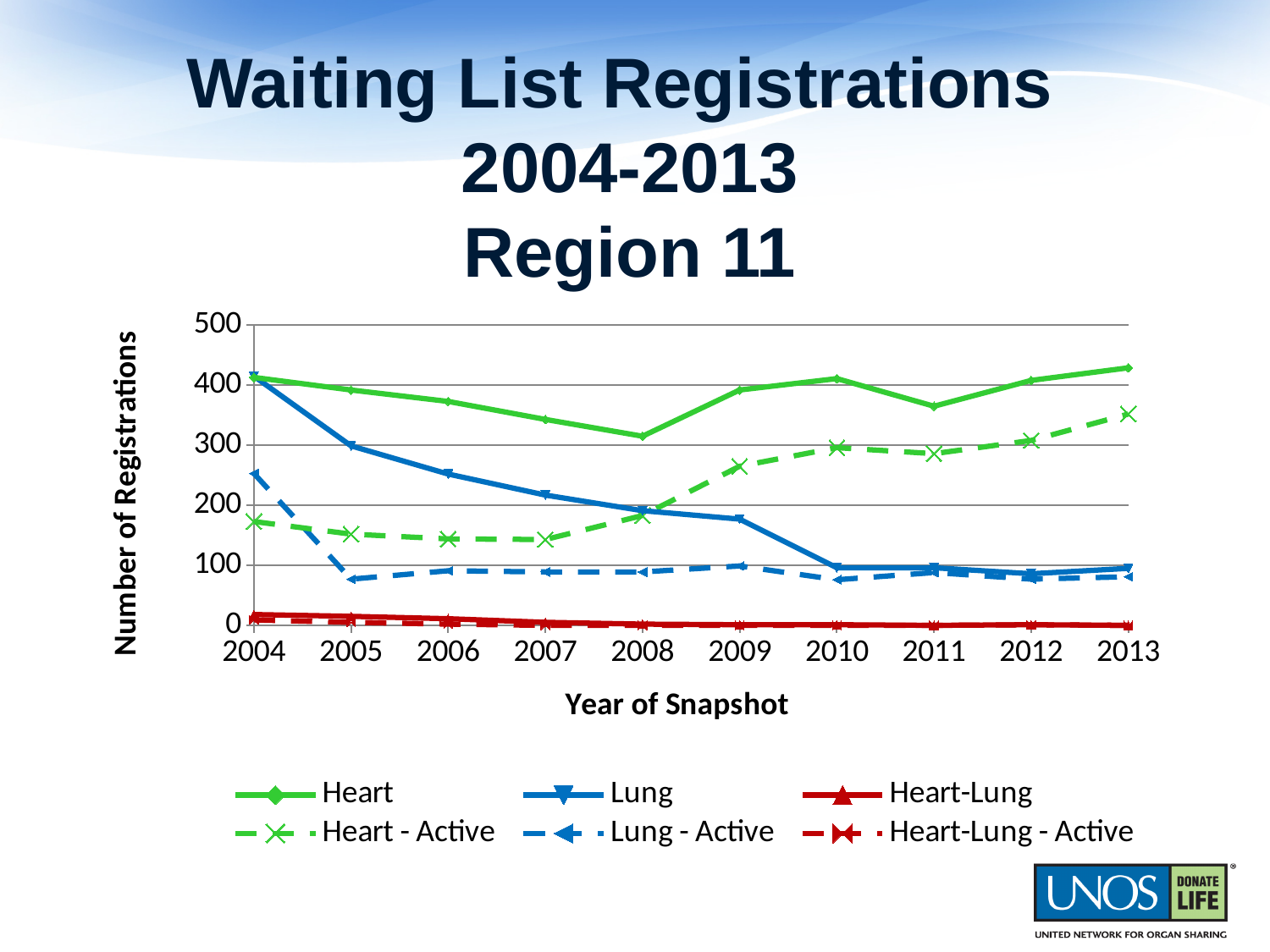
Is the Lung value for 2004 greater or less than 300? greater Is the Lung value for 2010 greater or less than 200? less Does the Lung series rise or fall from 2004 to 2013? fall How many series does the legend list? 6 What kind of chart is shown on the slide? line chart In 2013, which is larger, the Heart value or the Lung value? Heart Is the Heart - Active value for 2013 greater or less than 300? greater How many years are plotted along the x axis? 10 In which year is the Heart series at its lowest? 2008 In which year is the Lung series at its highest? 2004